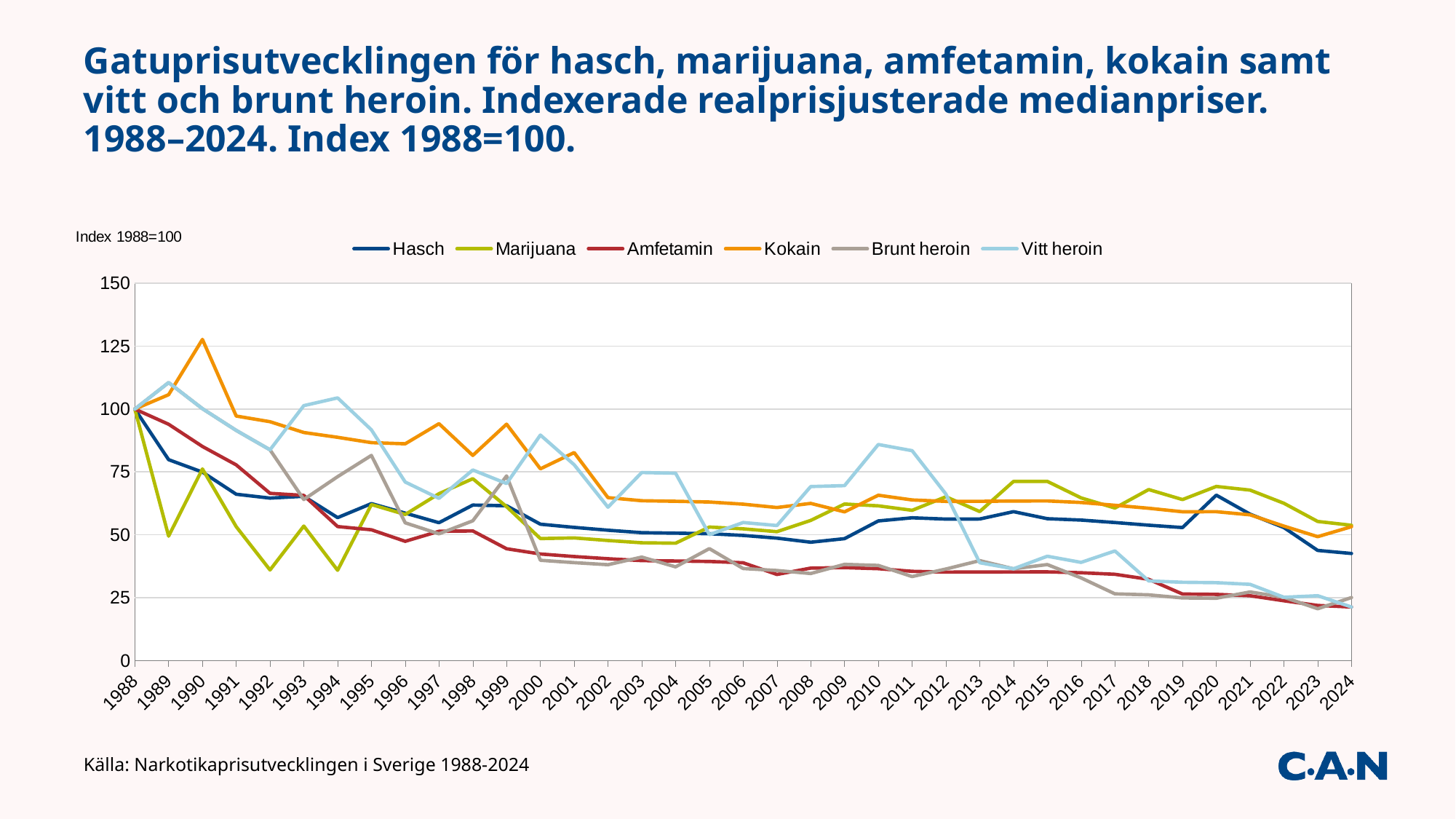
How many series does the legend list? 6 Which series has the lowest value in 1989? Marijuana Is the value for Marijuana in 1989 greater or less than 75? less Which is larger in 2024, the value for Hasch or the value for Amfetamin? Hasch What kind of chart is shown on the slide? line chart Does the Hasch series rise or fall overall from 1988 to 2024? fall Which series has the highest value in 1990? Kokain Is the value for Hasch in 2024 greater or less than 50? less What colour is the Kokain line in the legend? orange How many years are plotted along the x axis? 37 Is the value for Kokain in 1990 greater or less than 100? greater What is the index value for Hasch in 1988? 100